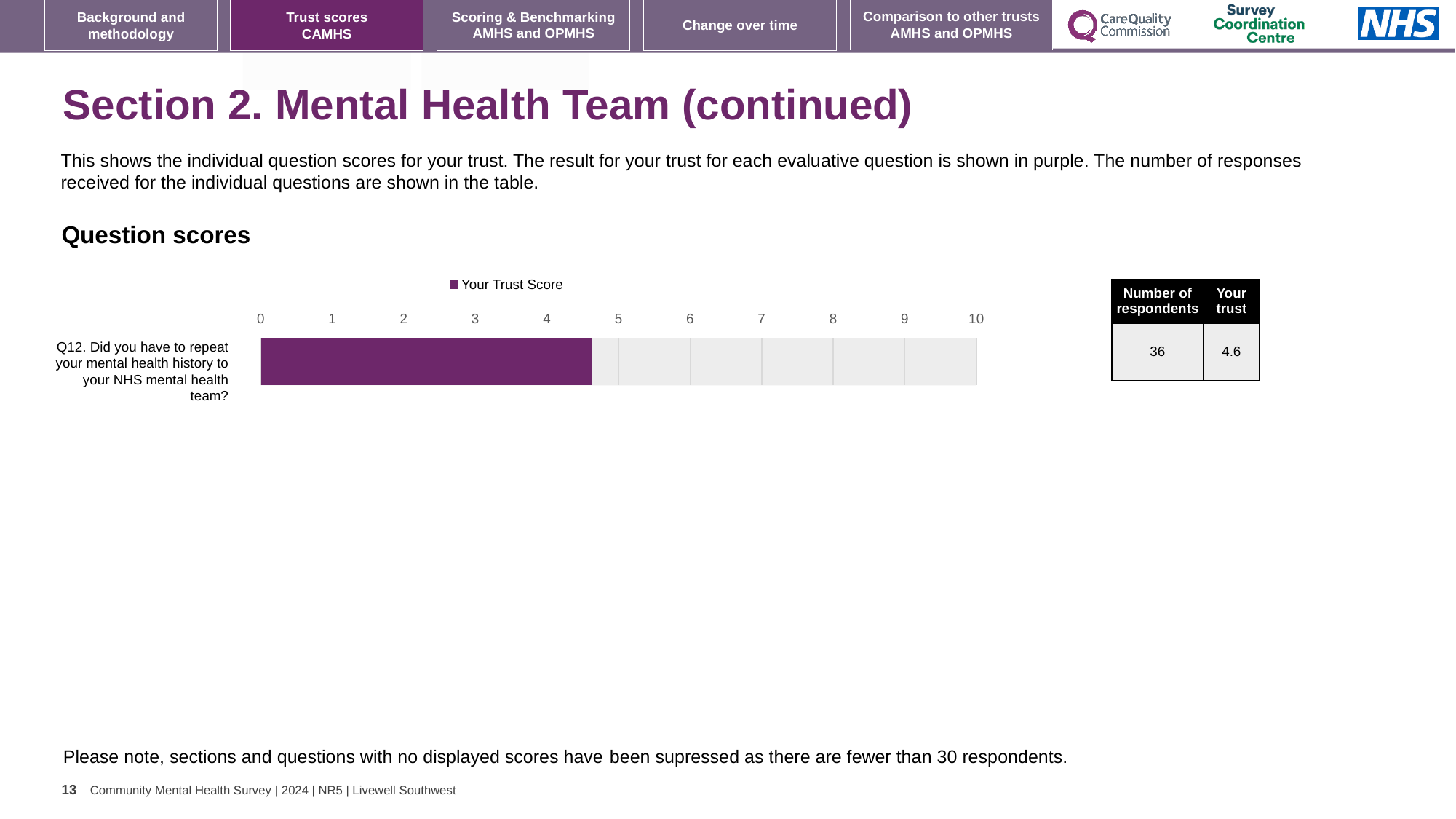
How many respondents answered Q12 according to the table next to the chart? 36 How many series does the legend of the Question scores chart list? 1 What is the trust score for Q12 (Did you have to repeat your mental health history to your NHS mental health team?)? 4.6 What is the name of the series shown in the legend of the Question scores chart? Your Trust Score What kind of chart is shown under "Question scores"? bar chart What is the maximum value shown on the x axis of the Question scores chart? 10 Is the trust score for Q12 greater or less than 5? less Is the trust score for Q12 greater or less than 3? greater Is the trust score for Q12 greater or less than 4? greater How many questions (bars) are plotted in the Question scores chart? 1